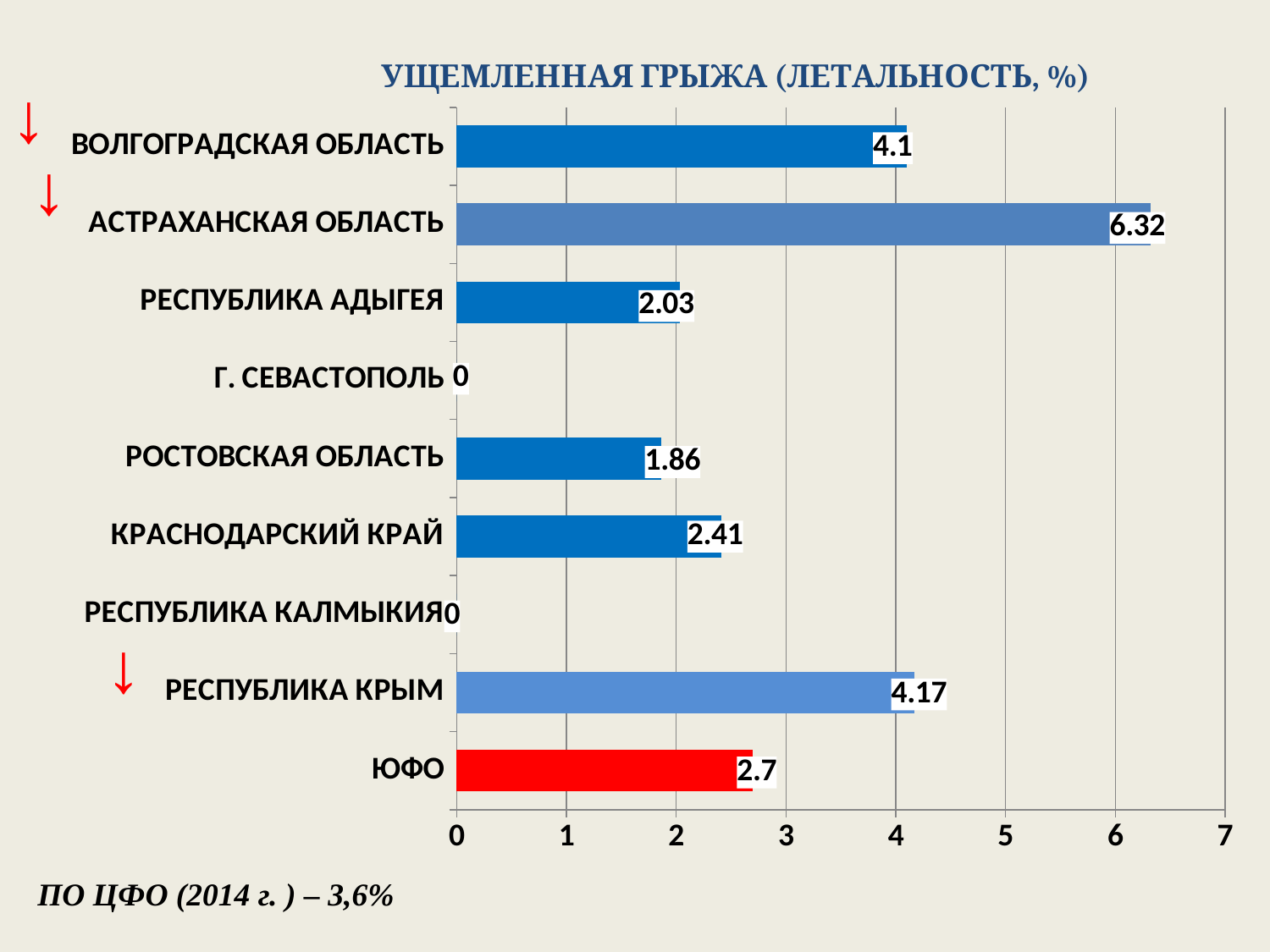
What is the difference between the values for Астраханская область and Волгоградская область? 2.22 What is the value for Ростовская область? 1.86 Which is larger, the value for Краснодарский край or the value for Республика Адыгея? Краснодарский край Which is larger, the value for Республика Крым or the value for Волгоградская область? Республика Крым How many categories have a value of 0? 2 What is the value for ЮФО? 2.7 Which category has the highest value? Астраханская область What is the value for Республика Крым? 4.17 What kind of chart is shown on the slide? bar chart What is the value for Астраханская область? 6.32 What is the title of the chart? УЩЕМЛЕННАЯ ГРЫЖА (ЛЕТАЛЬНОСТЬ, %) How many categories are shown on the chart? 9